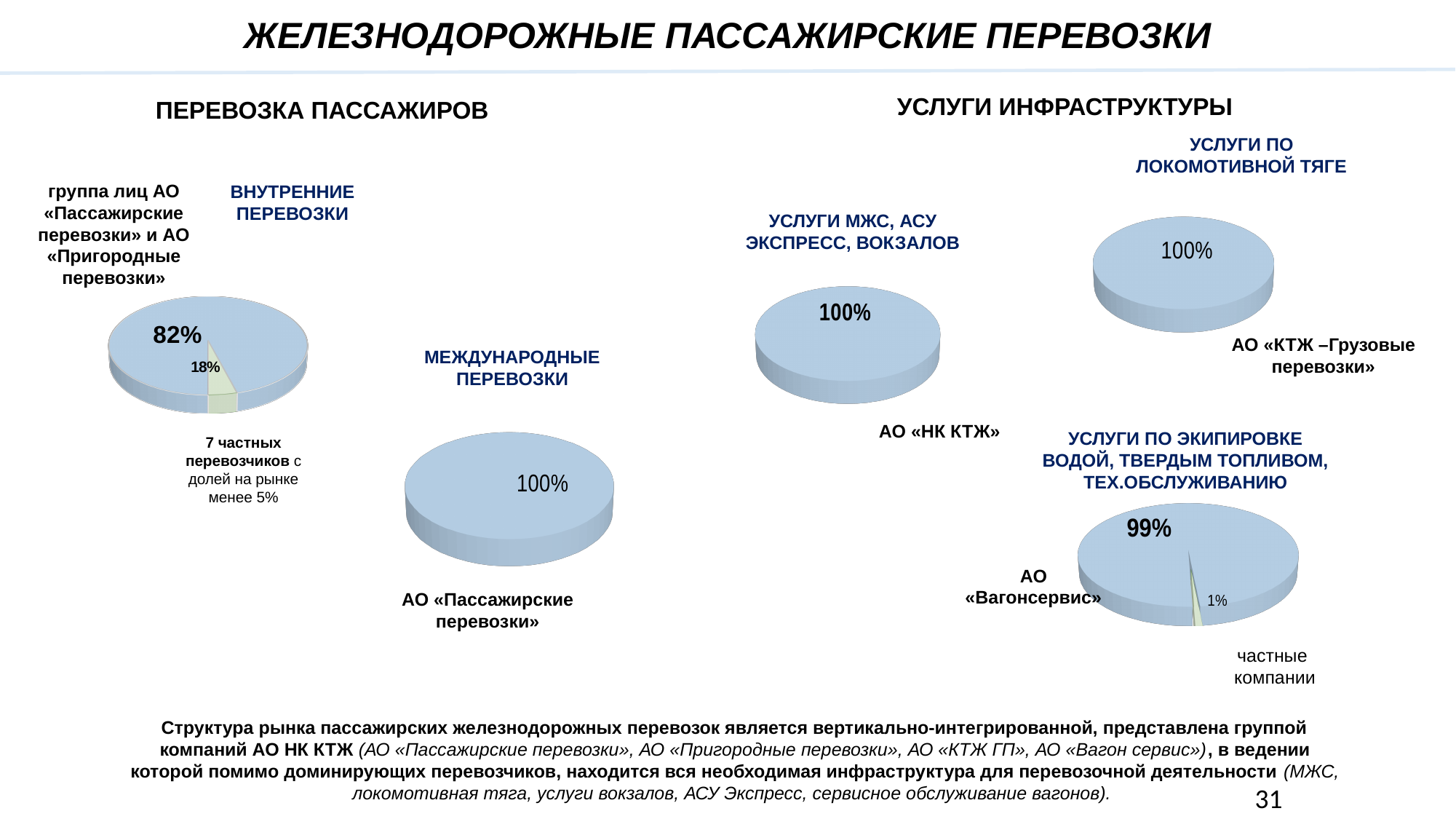
On the 'УСЛУГИ ПО ЭКИПИРОВКЕ ВОДОЙ, ТВЕРДЫМ ТОПЛИВОМ, ТЕХ.ОБСЛУЖИВАНИЮ' pie chart, which slice is the smallest? частные компании (1%) On the 'УСЛУГИ МЖС, АСУ ЭКСПРЕСС, ВОКЗАЛОВ' pie chart, what share does АО «НК КТЖ» hold? 100% On the 'УСЛУГИ ПО ЛОКОМОТИВНОЙ ТЯГЕ' pie chart, which company holds 100%? АО «КТЖ –Грузовые перевозки» How many pie charts are shown on the slide? 5 On the 'ВНУТРЕННИЕ ПЕРЕВОЗКИ' pie chart, which slice is the largest? группа лиц АО «Пассажирские перевозки» и АО «Пригородные перевозки» (82%) On the 'УСЛУГИ ПО ЭКИПИРОВКЕ ВОДОЙ, ТВЕРДЫМ ТОПЛИВОМ, ТЕХ.ОБСЛУЖИВАНИЮ' pie chart, what share do private companies (частные компании) hold? 1% On the 'МЕЖДУНАРОДНЫЕ ПЕРЕВОЗКИ' pie chart, what share does АО «Пассажирские перевозки» hold? 100% On the 'ВНУТРЕННИЕ ПЕРЕВОЗКИ' pie chart, what share is held by the 7 private carriers? 18% On the 'ВНУТРЕННИЕ ПЕРЕВОЗКИ' pie chart, what share is held by the group of АО «Пассажирские перевозки» and АО «Пригородные перевозки»? 82% On the 'УСЛУГИ ПО ЭКИПИРОВКЕ ВОДОЙ, ТВЕРДЫМ ТОПЛИВОМ, ТЕХ.ОБСЛУЖИВАНИЮ' pie chart, what share does АО «Вагонсервис» hold? 99% What type of chart is used for 'ВНУТРЕННИЕ ПЕРЕВОЗКИ'? Pie chart On the 'ВНУТРЕННИЕ ПЕРЕВОЗКИ' pie chart, what is the difference between the 82% slice and the 18% slice? 64 percentage points